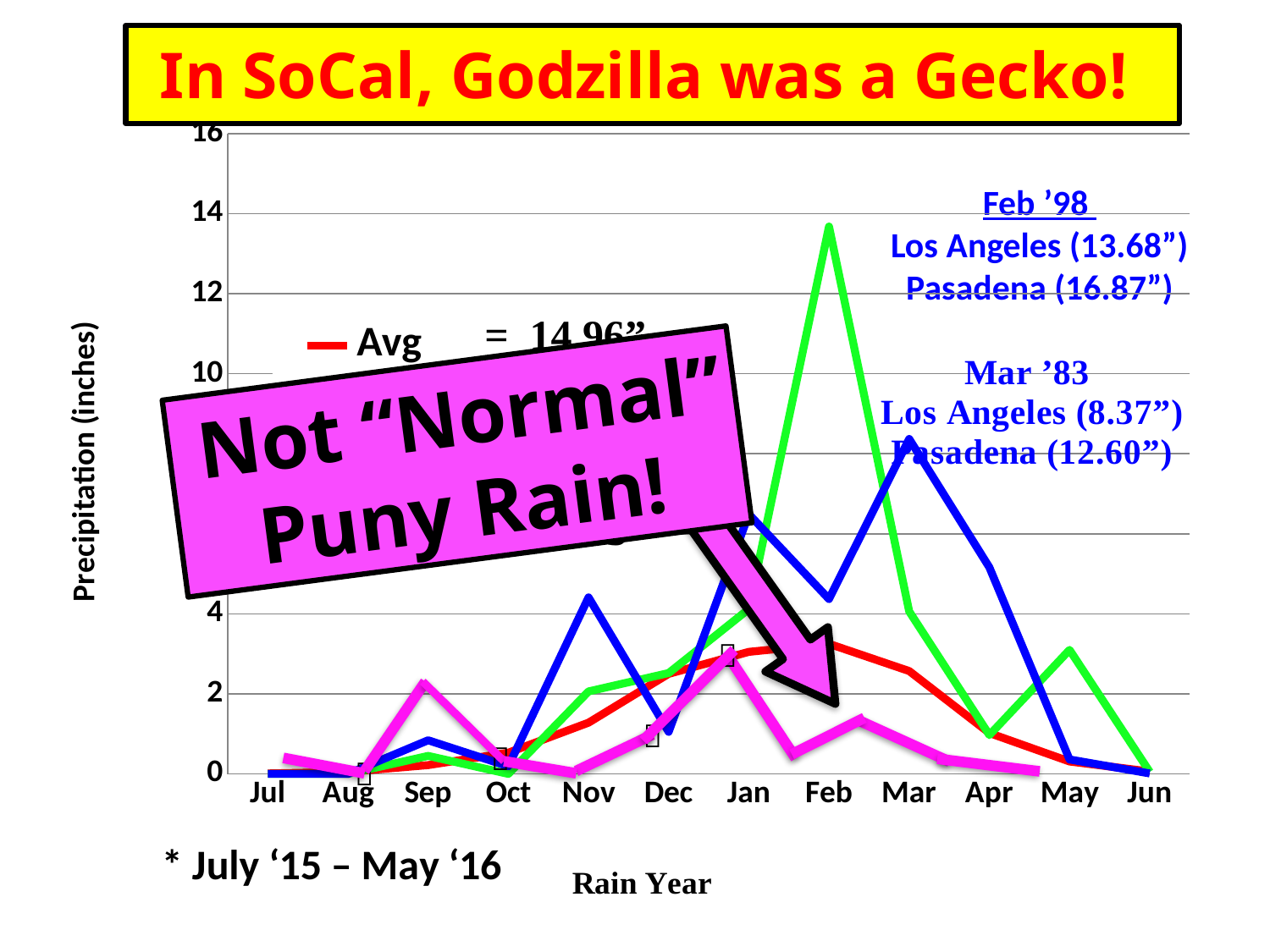
Is the value of the red Avg line in Feb greater or less than 4? less What is the title of the y axis? Precipitation (inches) What kind of chart is shown on the slide? line chart In which month does the green line reach its highest value? Feb What total value is given for the Avg series in the legend? 14.96" Is the value of the green line in Feb greater or less than 12? greater According to the annotation, what was the Los Angeles precipitation in Feb '98? 13.68" How many months are shown along the x axis of the chart? 12 In which month does the blue line reach its highest value? Mar According to the annotation, what was the Pasadena precipitation in Mar '83? 12.60" By how much did Pasadena's Feb '98 precipitation exceed Los Angeles's Feb '98 precipitation, according to the annotations? 3.19" What is the title of the x axis? Rain Year